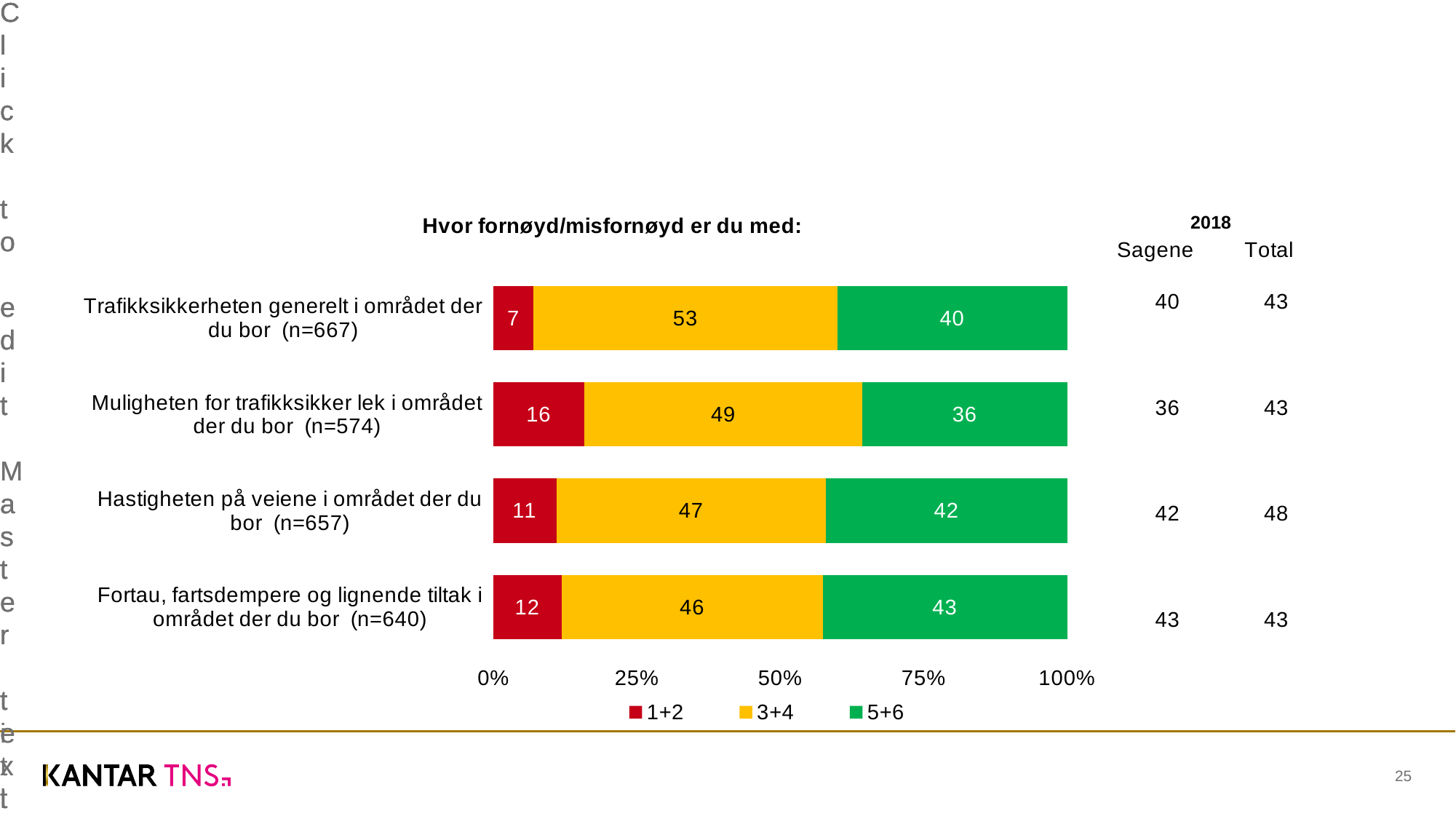
How many categories are plotted in the chart? 4 What is the value of the 1+2 segment for "Muligheten for trafikksikker lek i området der du bor (n=574)"? 16 How many series does the legend list? 3 What is the value of the 5+6 segment for "Trafikksikkerheten generelt i området der du bor (n=667)"? 40 What is the value of the 3+4 segment for "Hastigheten på veiene i området der du bor (n=657)"? 47 Which is larger: the 5+6 value for "Hastigheten på veiene i området der du bor (n=657)" or the 5+6 value for "Muligheten for trafikksikker lek i området der du bor (n=574)"? Hastigheten på veiene i området der du bor (n=657) What is the total of the stacked bar for "Fortau, fartsdempere og lignende tiltak i området der du bor (n=640)"? 101 What is the difference between the 3+4 values for "Trafikksikkerheten generelt i området der du bor (n=667)" and "Fortau, fartsdempere og lignende tiltak i området der du bor (n=640)"? 7 Which category has the highest 1+2 value? Muligheten for trafikksikker lek i området der du bor (n=574) What colour represents the 5+6 series in the chart? Green What kind of chart is shown on the slide? Stacked bar chart Which category has the lowest 1+2 value? Trafikksikkerheten generelt i området der du bor (n=667)